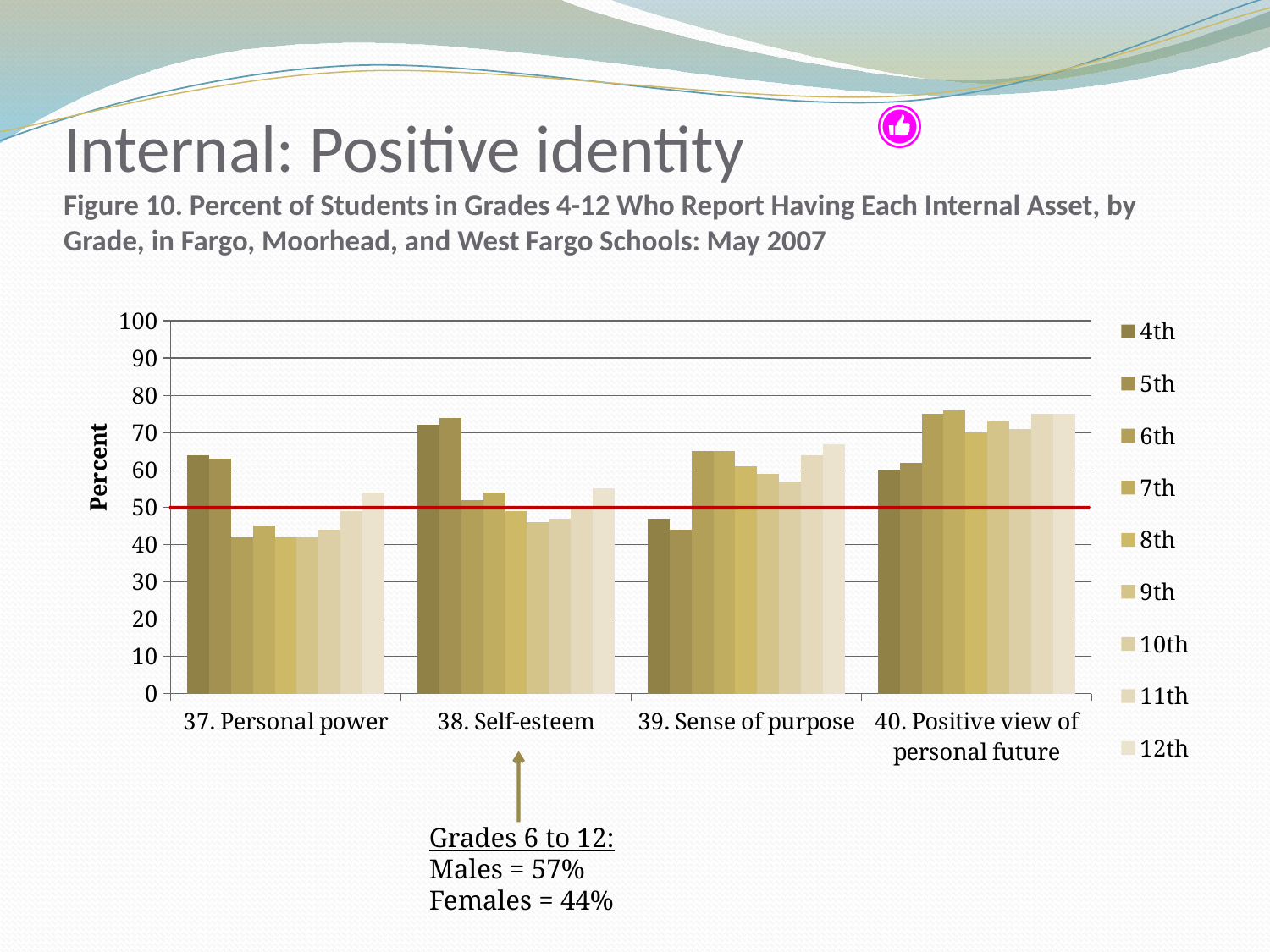
Is the value for 5th grade in 38. Self-esteem greater or less than 70? greater Is the value for 6th grade in 37. Personal power greater or less than 50? less How many categories (assets) are shown on the x axis? 4 Is the value for 12th grade in 39. Sense of purpose greater or less than 60? greater What is the label on the vertical axis of the chart? Percent What kind of chart is shown on the slide? bar chart In 39. Sense of purpose, which is larger: the value for 4th grade or the value for 12th grade? 12th How many series (grades) does the legend list? 9 In 38. Self-esteem, which is larger: the value for 4th grade or the value for 8th grade? 4th